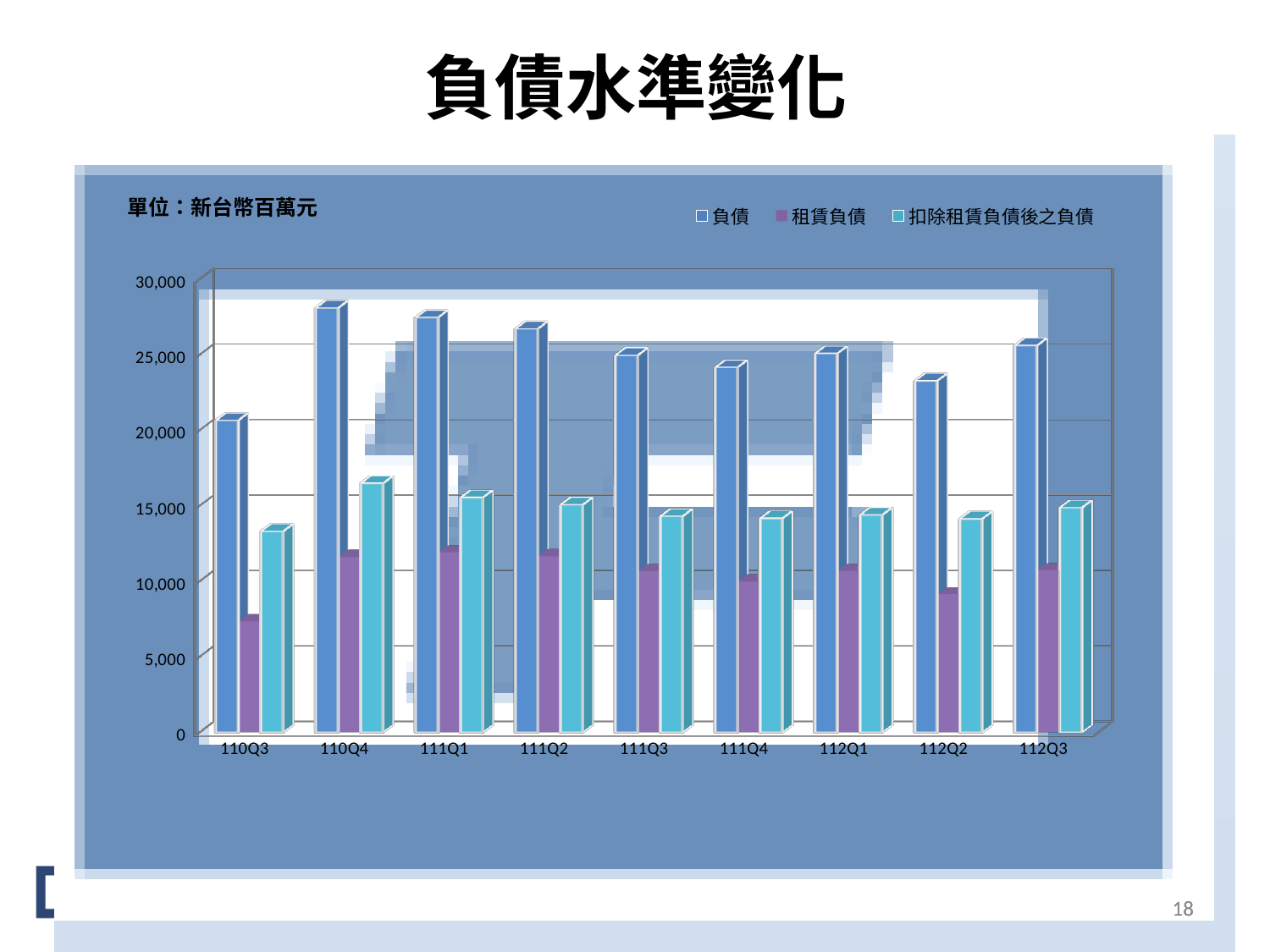
Is the value for 負債 in 112Q2 greater or less than 25,000? less What unit is stated for the values in the chart? 新台幣百萬元 Which quarter has the highest value for 負債? 110Q4 Is the value for 負債 in 110Q4 greater or less than 25,000? greater Which quarter has the lowest value for 租賃負債? 110Q3 Which is larger, the 負債 value for 110Q4 or for 112Q2? 110Q4 How many quarters (categories) are shown on the x axis? 9 How many series does the legend list? 3 Which quarter has the highest value for 扣除租賃負債後之負債? 110Q4 Is the value for 租賃負債 in 110Q3 greater or less than 10,000? less Which quarter has the lowest value for 負債? 110Q3 What kind of chart is shown on the slide? bar chart